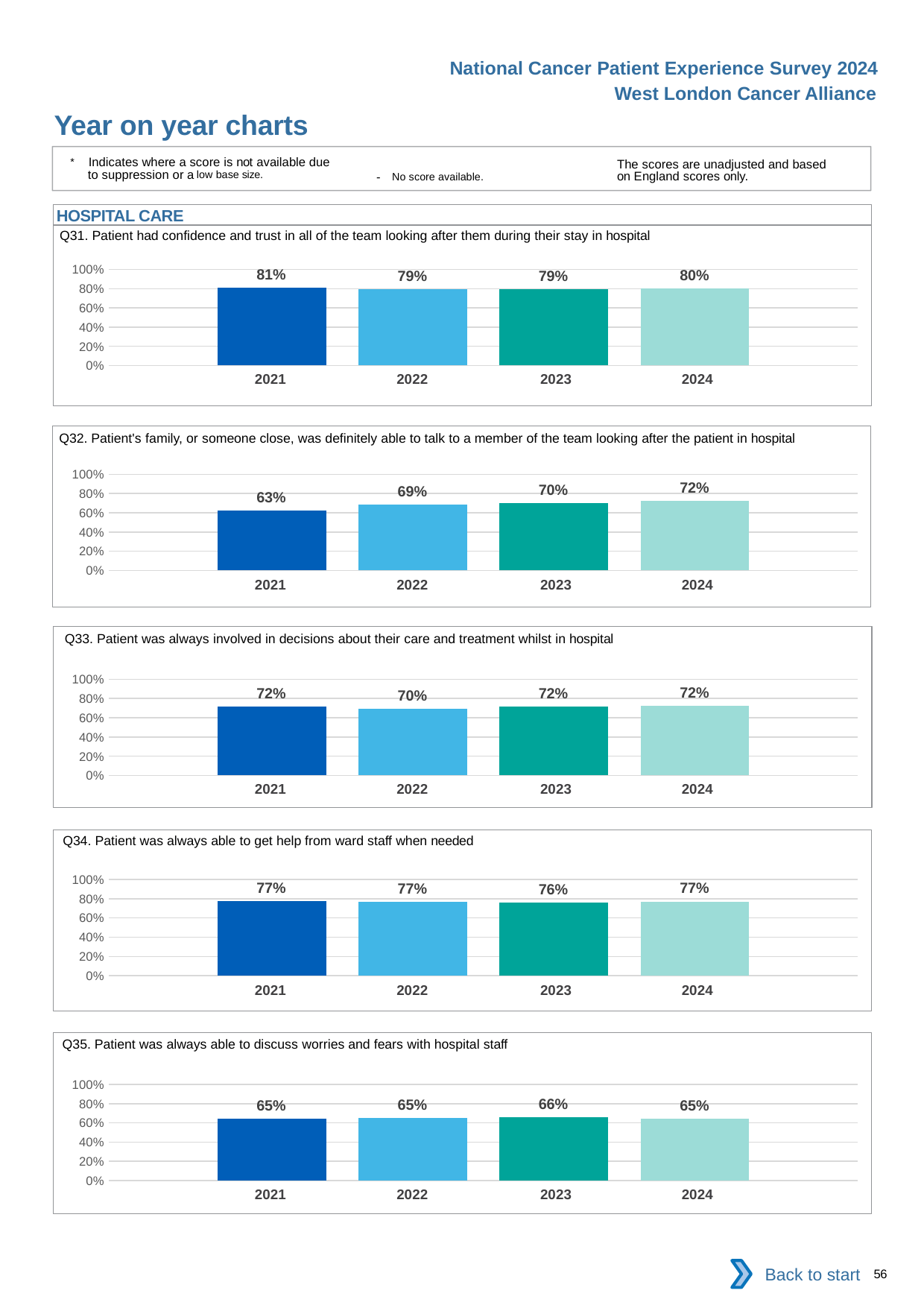
In the Q32 chart, do the values rise or fall from 2021 to 2024? rise In the Q33 chart, which year has the lowest value? 2022 In the Q35 chart, which year has the highest value? 2023 In the Q32 chart, what is the value for 2024? 72% In the Q34 chart, is the value for 2021 greater or less than 60%? greater How many years are shown in the Q35 chart? 4 In the Q33 chart, what is the value for 2022? 70% In the Q32 chart, what is the difference between the 2024 value and the 2021 value? 9 percentage points In the Q31 chart, which year has the lowest value? 2022 and 2023 In the Q34 chart, what is the value for 2023? 76% In the Q31 chart, what is the value for 2021? 81% What kind of chart is used for Q31? bar chart